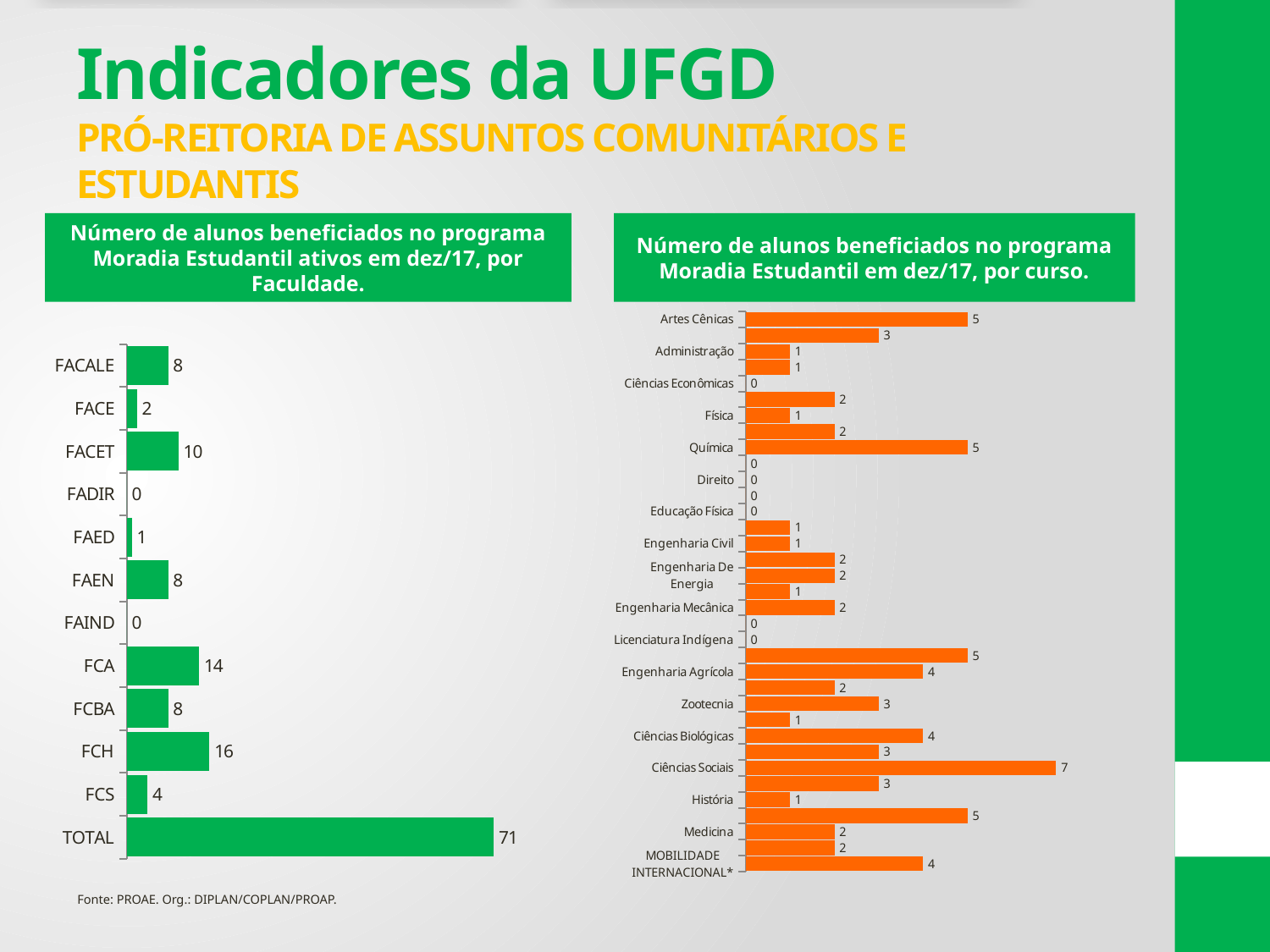
What colour are the bars in the right chart (por curso)? Orange In the right chart (por curso), what is the value for MOBILIDADE INTERNACIONAL*? 4 In the right chart (por curso), what is the value for Ciências Sociais? 7 In the left chart (by Faculdade), how many students does FCH have? 16 What type of chart is the left chart (by Faculdade)? Bar chart In the left chart (by Faculdade), how many bars are plotted, including TOTAL? 12 In the left chart (by Faculdade), what is the value shown for TOTAL? 71 In the left chart (by Faculdade), which faculty, excluding TOTAL, has the highest number of students? FCH In the left chart (by Faculdade), what is the value for FACET? 10 In the left chart (by Faculdade), which is larger, FACET or FAEN? FACET In the left chart (by Faculdade), how many faculties show a value of 0? 2 In the left chart (by Faculdade), what is the difference between FCH and FCA? 2